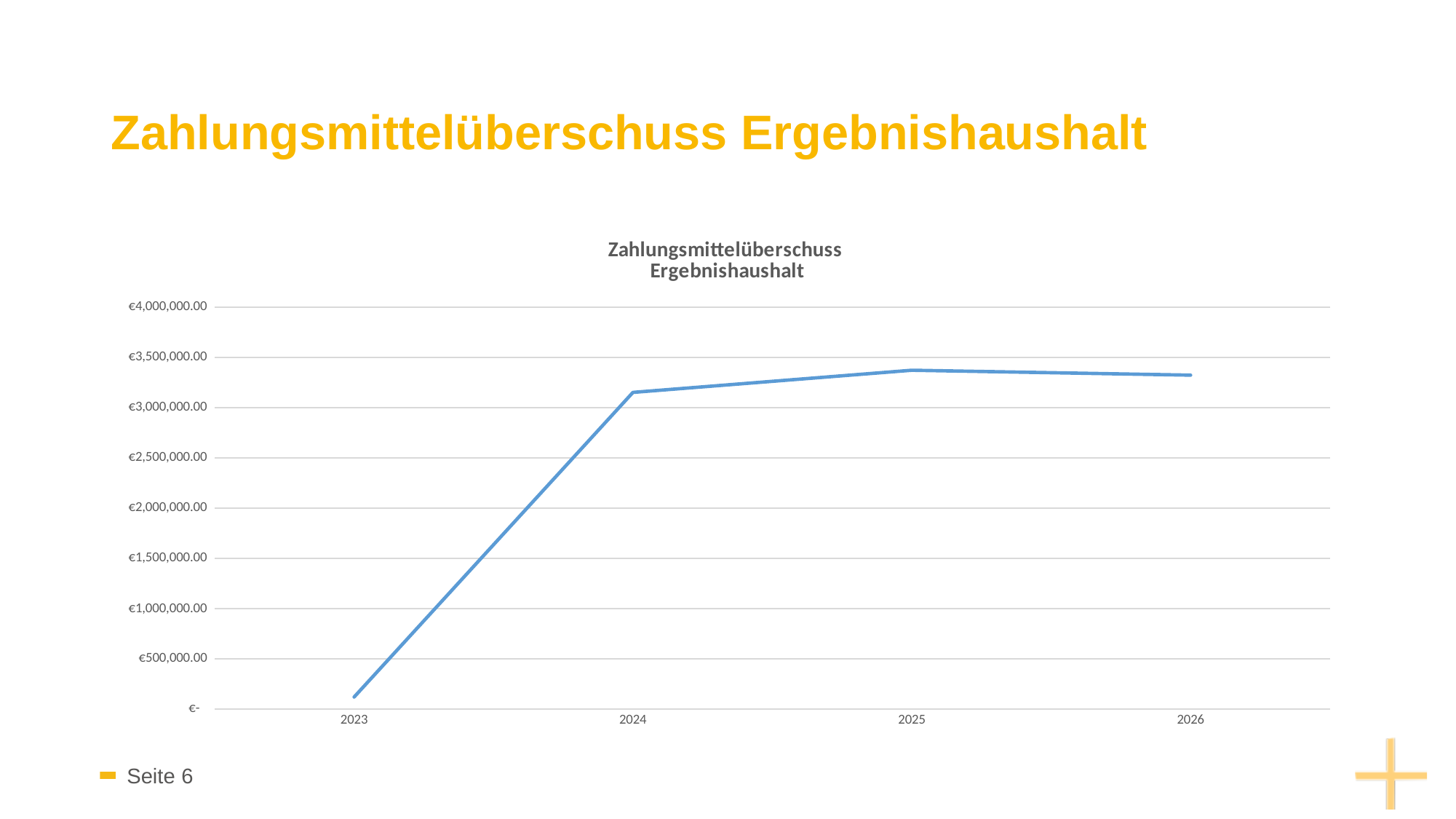
Which year has the lowest value in the chart? 2023 Does the value rise or fall from 2023 to 2024? rise Which is larger, the value for 2024 or the value for 2025? 2025 What is the highest value shown on the y axis of the chart? €4,000,000.00 Is the value for 2026 greater or less than €3,000,000.00? greater What kind of chart is shown on the slide? line chart Is the value for 2025 greater or less than €3,500,000.00? less Is the value for 2024 greater or less than €3,000,000.00? greater How many years are plotted on the x axis of the chart? 4 Which is larger, the value for 2023 or the value for 2024? 2024 What is the title of the chart? Zahlungsmittelüberschuss Ergebnishaushalt